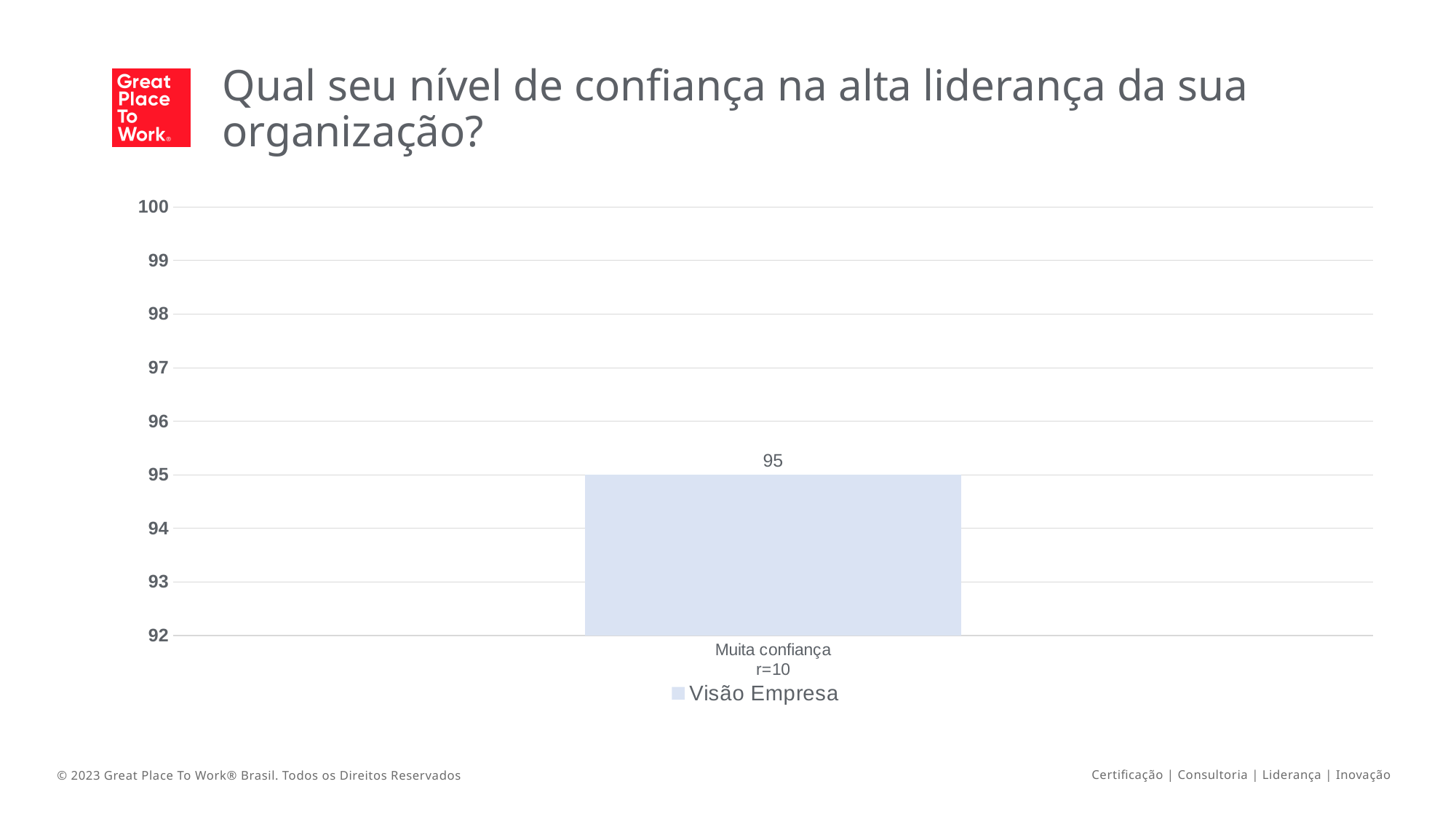
How many categories are plotted on the x axis? 1 Is the value for "Muita confiança" greater or less than 96? less Is the value for "Muita confiança" greater or less than 94? greater What kind of chart is shown on the slide? bar chart What is the value for "Muita confiança"? 95 How many series does the legend list? 1 What is the lowest value shown on the y axis? 92 What is the category label shown under the bar? Muita confiança r=10 What is the highest value shown on the y axis? 100 What series name appears in the legend? Visão Empresa